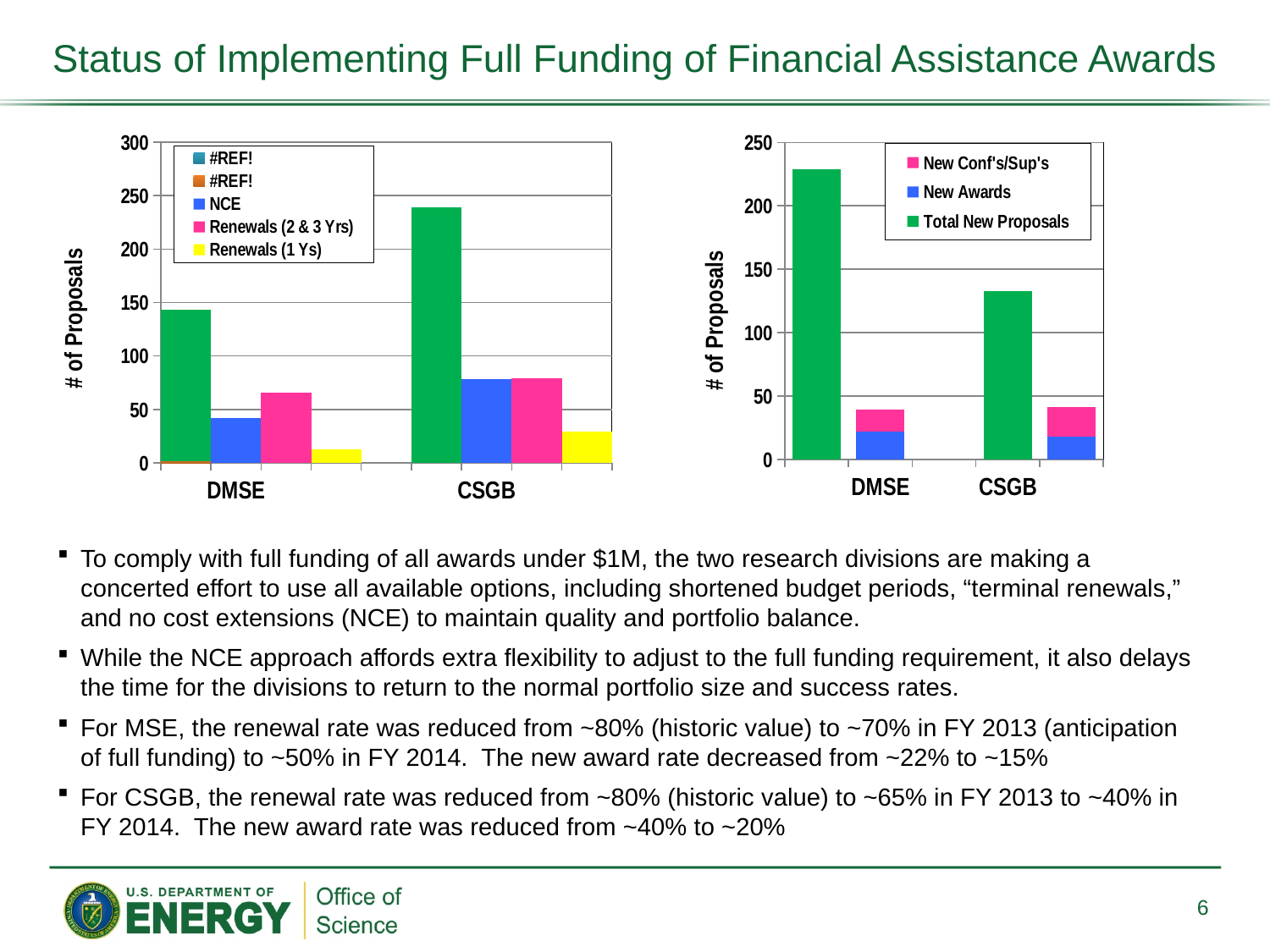
In the left chart, is the NCE value for DMSE greater or less than 50? less How many series does the legend of the left chart list? 5 How many categories are shown on the x axis of the left chart? 2 In the right chart, which category has the higher Total New Proposals value? DMSE What is the y-axis label of the right chart? # of Proposals What kind of chart is the chart on the left side of the slide? bar chart In the right chart, is the Total New Proposals value for DMSE greater or less than 200? greater In the left chart, is the Renewals (1 Ys) value for CSGB greater or less than 50? less How many series does the legend of the right chart list? 3 In the left chart, which category has the larger NCE value, DMSE or CSGB? CSGB